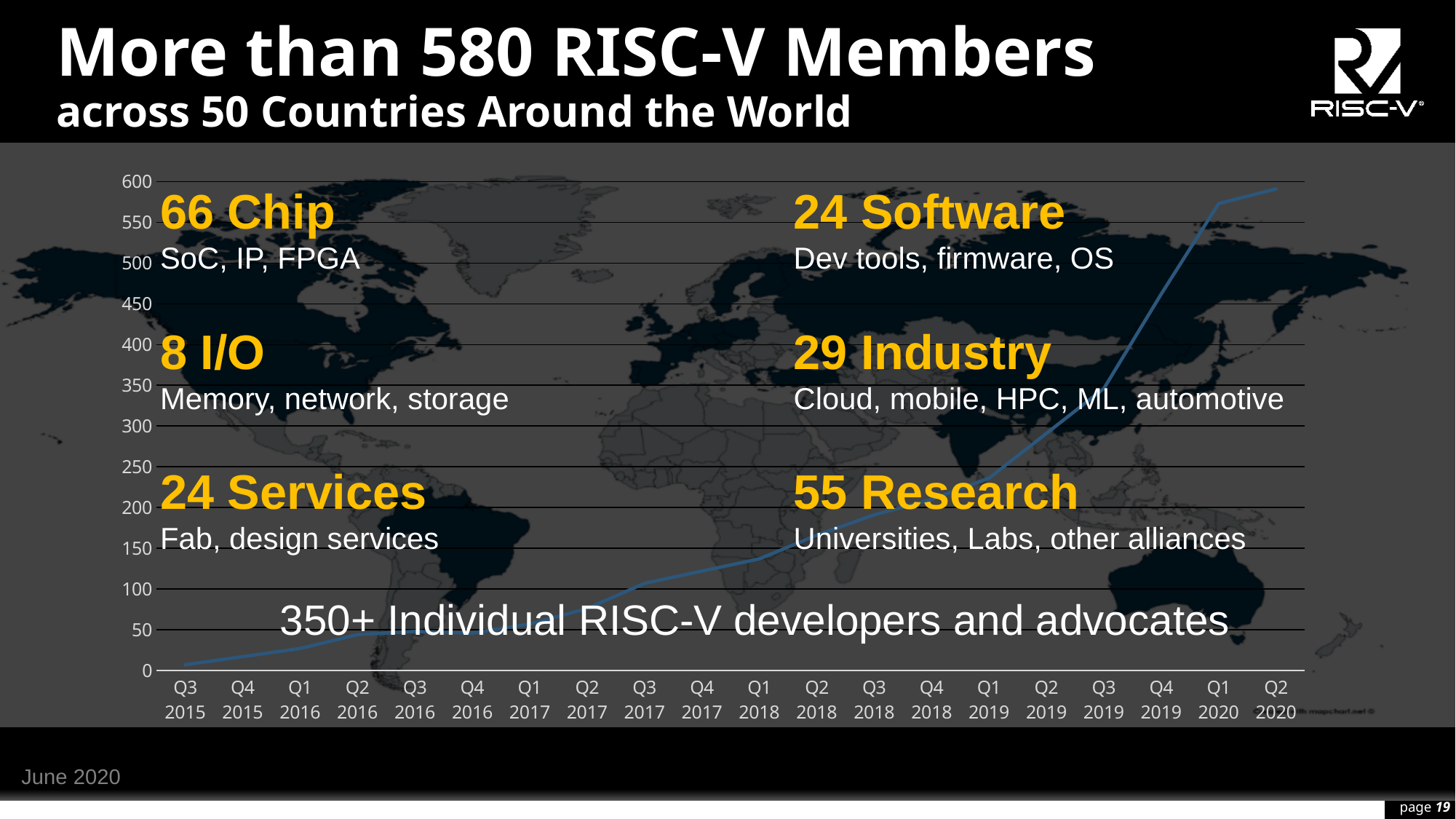
Which is larger, the value for Q1 2020 or the value for Q1 2019? Q1 2020 Is the value for Q2 2017 greater or less than 100? less Does the line in the chart rise or fall from Q3 2015 to Q2 2020? rise Is the value for Q1 2018 greater or less than 100? greater Which quarter has the lowest value on the line chart? Q3 2015 Which quarter has the highest value on the line chart? Q2 2020 What kind of chart is shown on the slide? line chart How many quarters are plotted along the x axis of the line chart? 20 Is the value for Q2 2020 greater or less than 550? greater What is the first quarter shown on the x axis of the line chart? Q3 2015